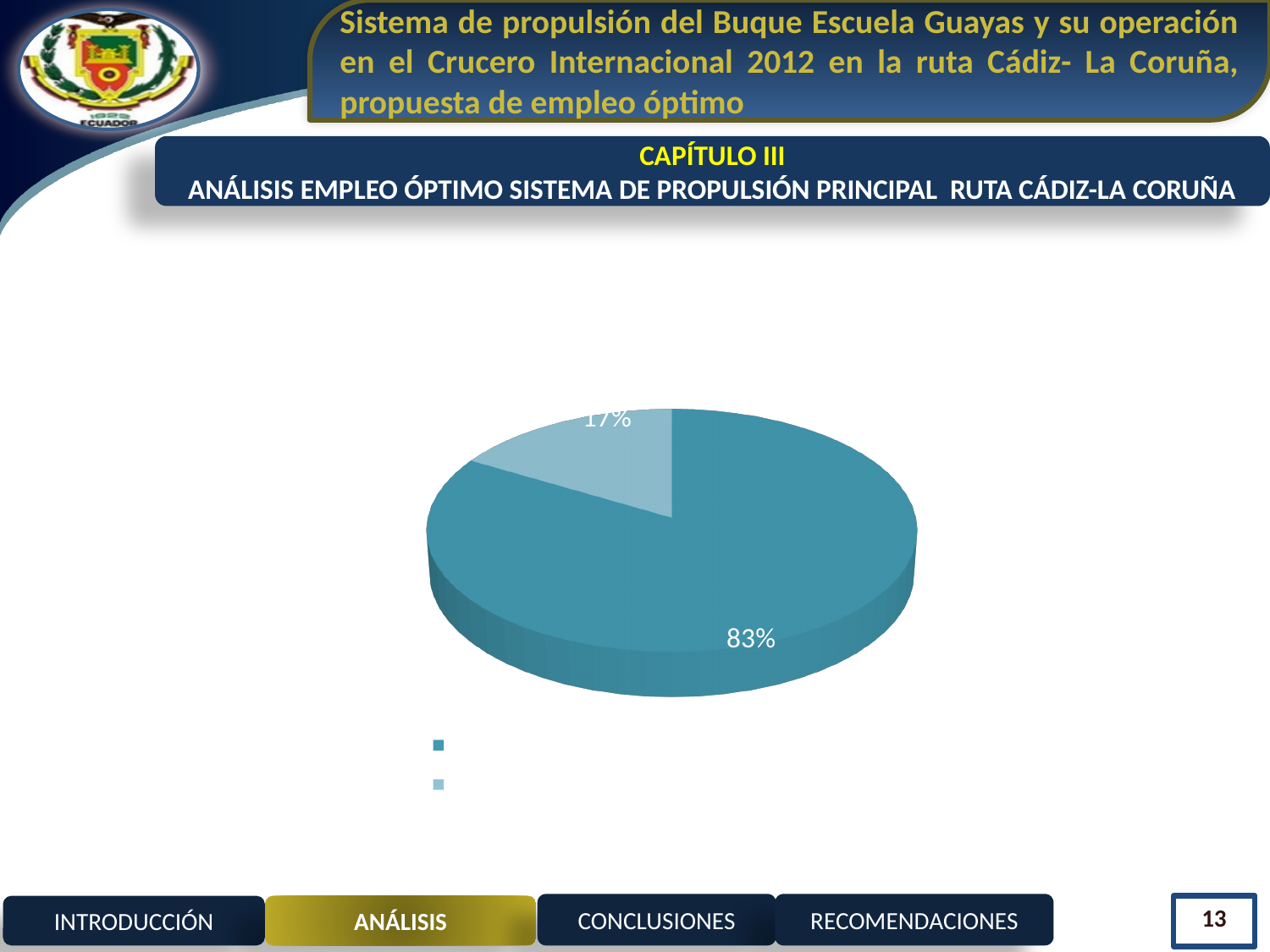
Which slice is larger, the dark teal one or the light teal one? the dark teal one What is the share of the smallest slice in the pie chart? 17% What colour is the slice labelled 17%? light teal By how many percentage points does the larger slice exceed the smaller slice? 66 What is the share of the largest slice in the pie chart? 83% How many entries does the legend below the pie chart list? 2 How many slices does the pie chart have? 2 What percentage is shown on the larger, darker teal slice of the pie chart? 83% What kind of chart is shown on the slide? pie chart Is the share of the dark teal slice greater or less than 50%? greater What percentage is shown on the smaller, lighter teal slice of the pie chart? 17%